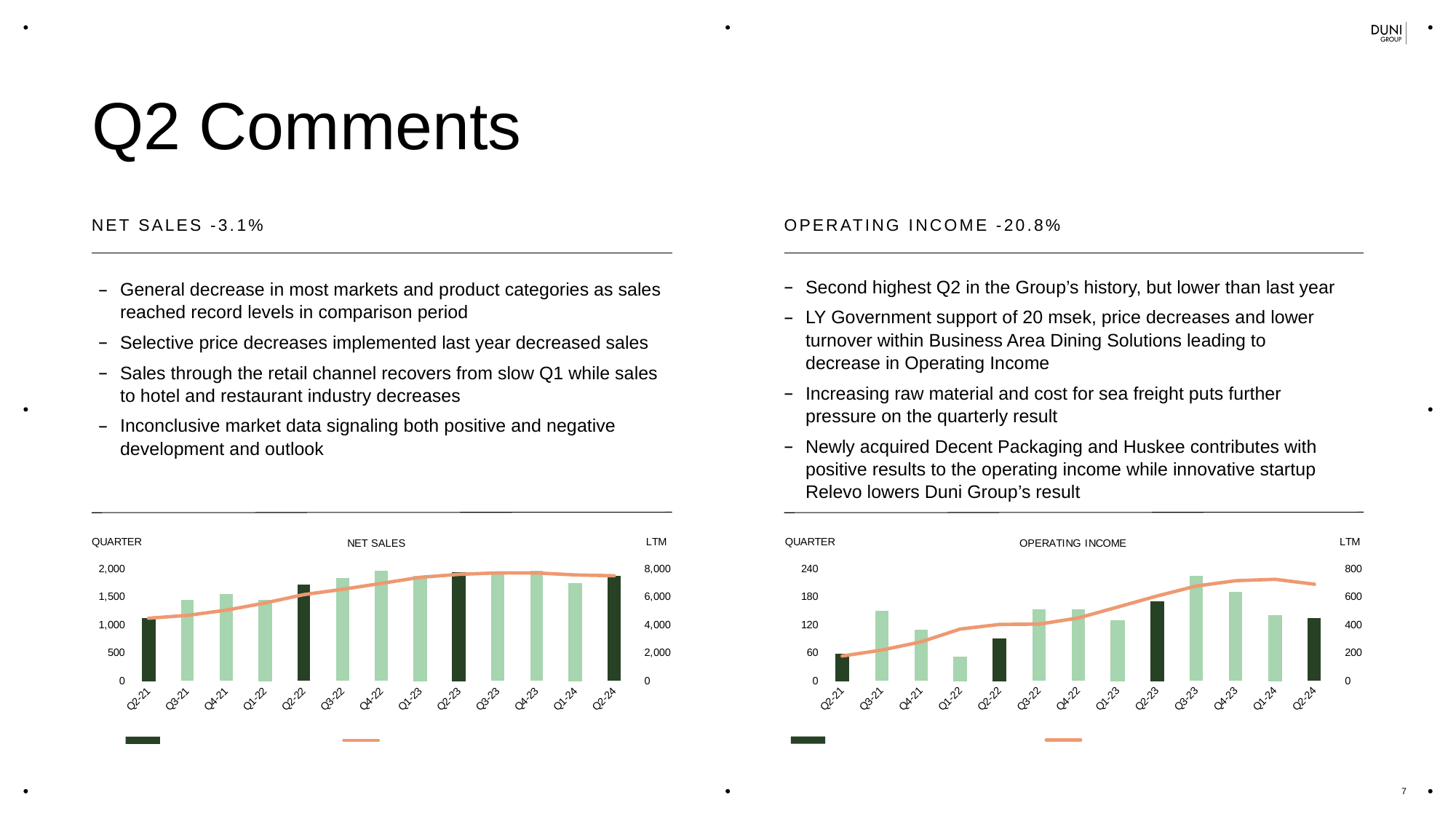
On the OPERATING INCOME chart, does the LTM line generally rise or fall from Q2-21 to Q3-23? rise On the NET SALES chart, what is the label of the right-hand axis? LTM On the OPERATING INCOME chart, is the quarterly value for Q3-23 greater or less than 180? greater On the NET SALES chart, is the quarterly value for Q2-22 greater or less than 1,500? greater On the NET SALES chart, which quarter has the larger bar, Q2-21 or Q2-24? Q2-24 On the NET SALES chart, how many quarters are shown on the x axis? 13 On the OPERATING INCOME chart, is the quarterly value for Q2-22 greater or less than 120? less On the OPERATING INCOME chart, which quarter has the highest quarterly operating income bar? Q3-23 What kind of chart is the OPERATING INCOME chart? Bar chart with a line On the OPERATING INCOME chart, which quarter has the larger bar, Q2-23 or Q2-24? Q2-23 On the NET SALES chart, which quarter has the lowest quarterly net sales bar? Q2-21